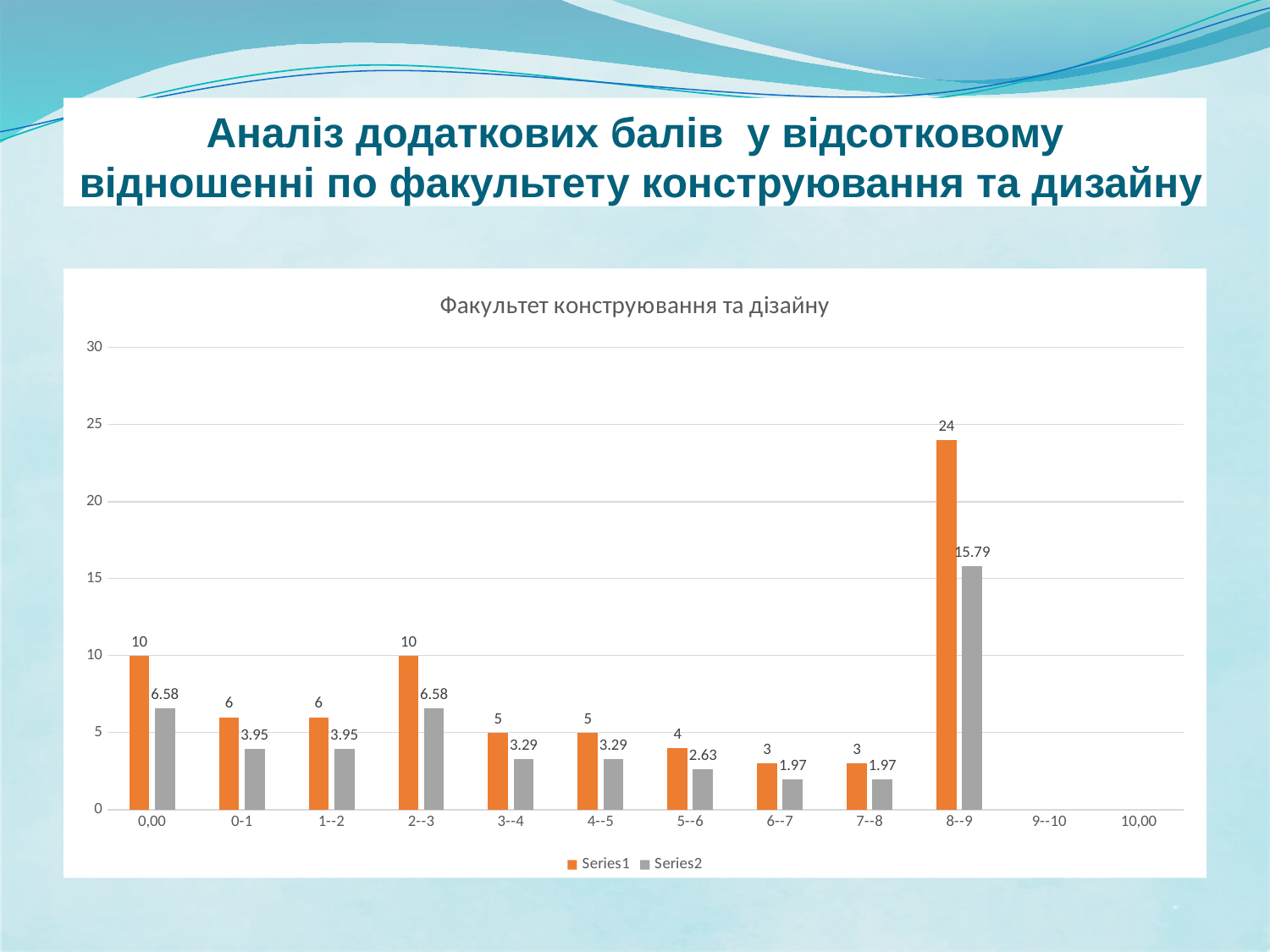
What is the Series2 value for the category 0,00? 6.58 What is the Series1 value for the category 8--9? 24 What is the Series1 value for the category 3--4? 5 What is the difference between the Series1 values for 2--3 and 6--7? 7 What is the Series2 value for the category 5--6? 2.63 What is the difference between the Series1 and Series2 values for the category 8--9? 8.21 Is the Series2 value for 8--9 greater or less than 15? greater Which is larger, the Series2 value for 0-1 or the Series2 value for 7--8? 0-1 What type of chart is shown on the slide? Bar chart How many categories are shown on the x axis? 12 Which category has the highest Series1 value? 8--9 How many series does the legend list? 2